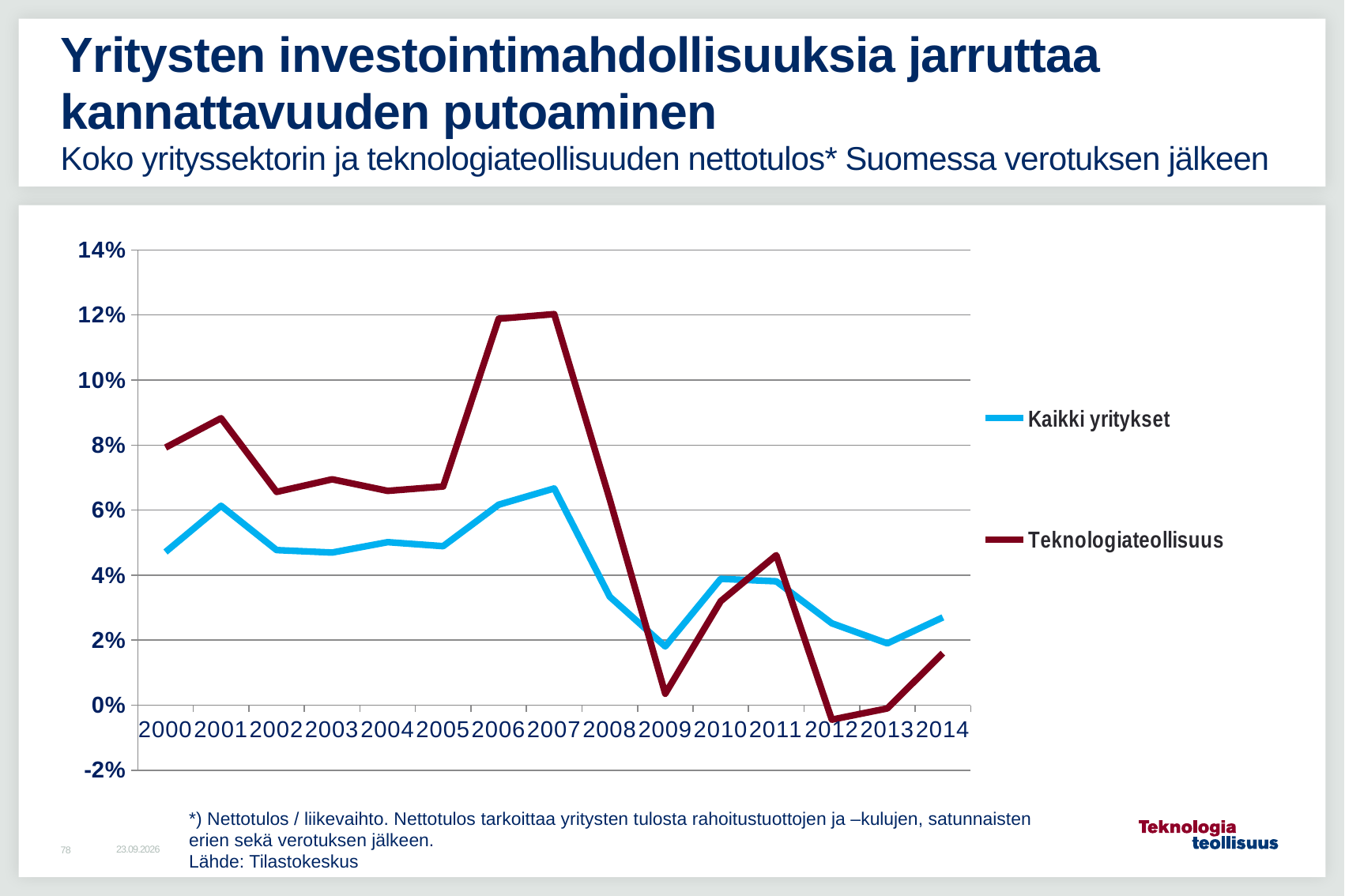
Does the Teknologiateollisuus series rise or fall from 2007 to 2009? fall Is the value for Teknologiateollisuus in 2006 greater or less than 10%? greater What kind of chart is shown on the slide? line chart How many years are shown on the x axis? 15 In 2011, which series has the higher value, Kaikki yritykset or Teknologiateollisuus? Teknologiateollisuus Which series is drawn in dark red? Teknologiateollisuus In which year does the Teknologiateollisuus series reach its lowest value? 2012 Is the value for Kaikki yritykset in 2000 greater or less than 6%? less In which year does the Kaikki yritykset series reach its highest value? 2007 How many series does the legend list? 2 In 2009, which series has the higher value, Kaikki yritykset or Teknologiateollisuus? Kaikki yritykset Is the value for Teknologiateollisuus in 2009 greater or less than 2%? less